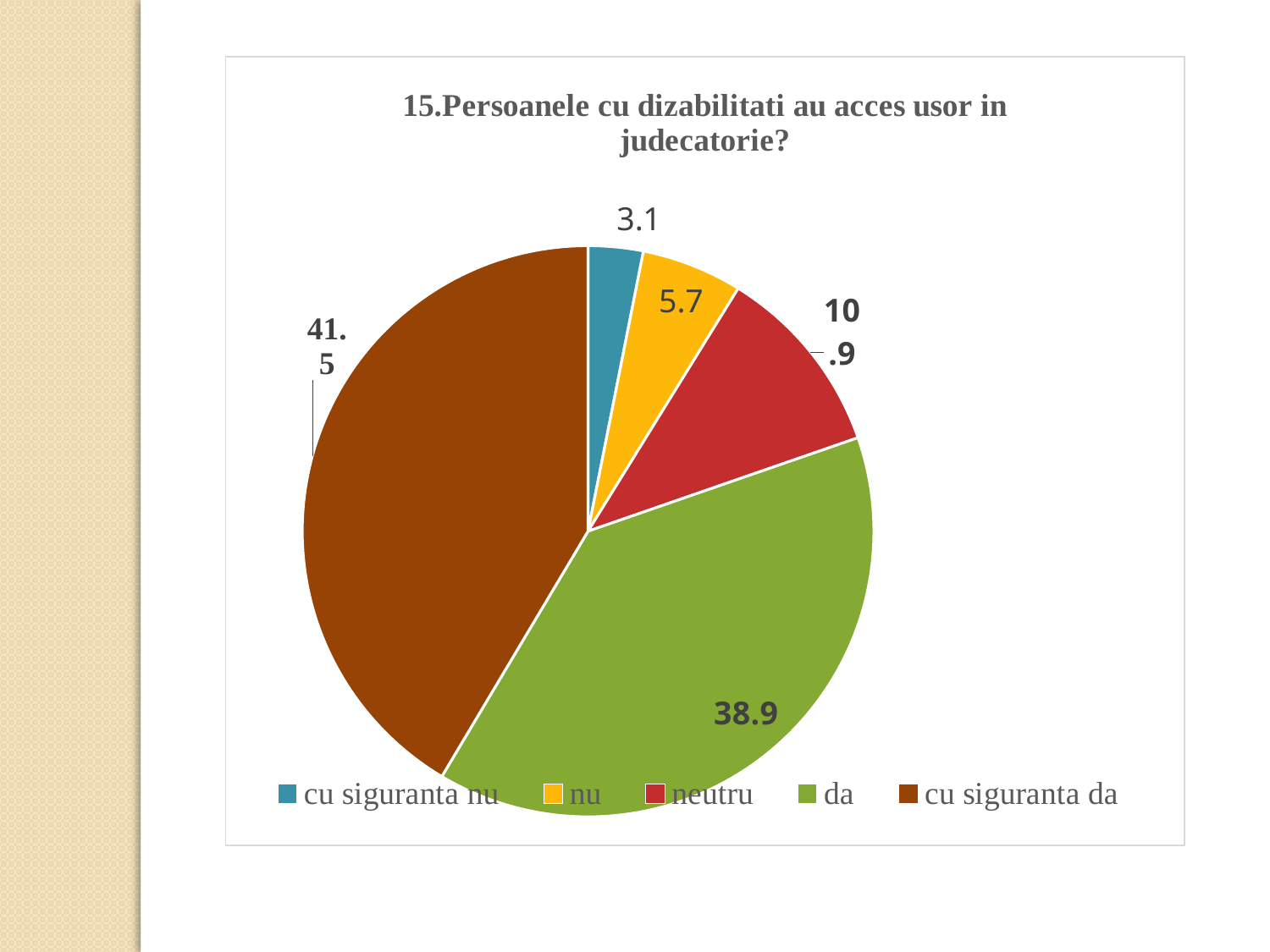
What type of chart is shown on the slide? pie chart Which category has the largest slice of the pie? cu siguranta da Which category has the smallest slice of the pie? cu siguranta nu Which is larger, the value for "nu" or the value for "neutru"? neutru What is the value for "neutru"? 10.9 What is the value for "cu siguranta nu"? 3.1 What is the value for "cu siguranta da"? 41.5 What is the title of the chart? 15.Persoanele cu dizabilitati au acces usor in judecatorie? What is the value for "da"? 38.9 How many categories does the pie chart have? 5 What is the difference between the values for "da" and "neutru"? 28 What is the value for "nu"? 5.7